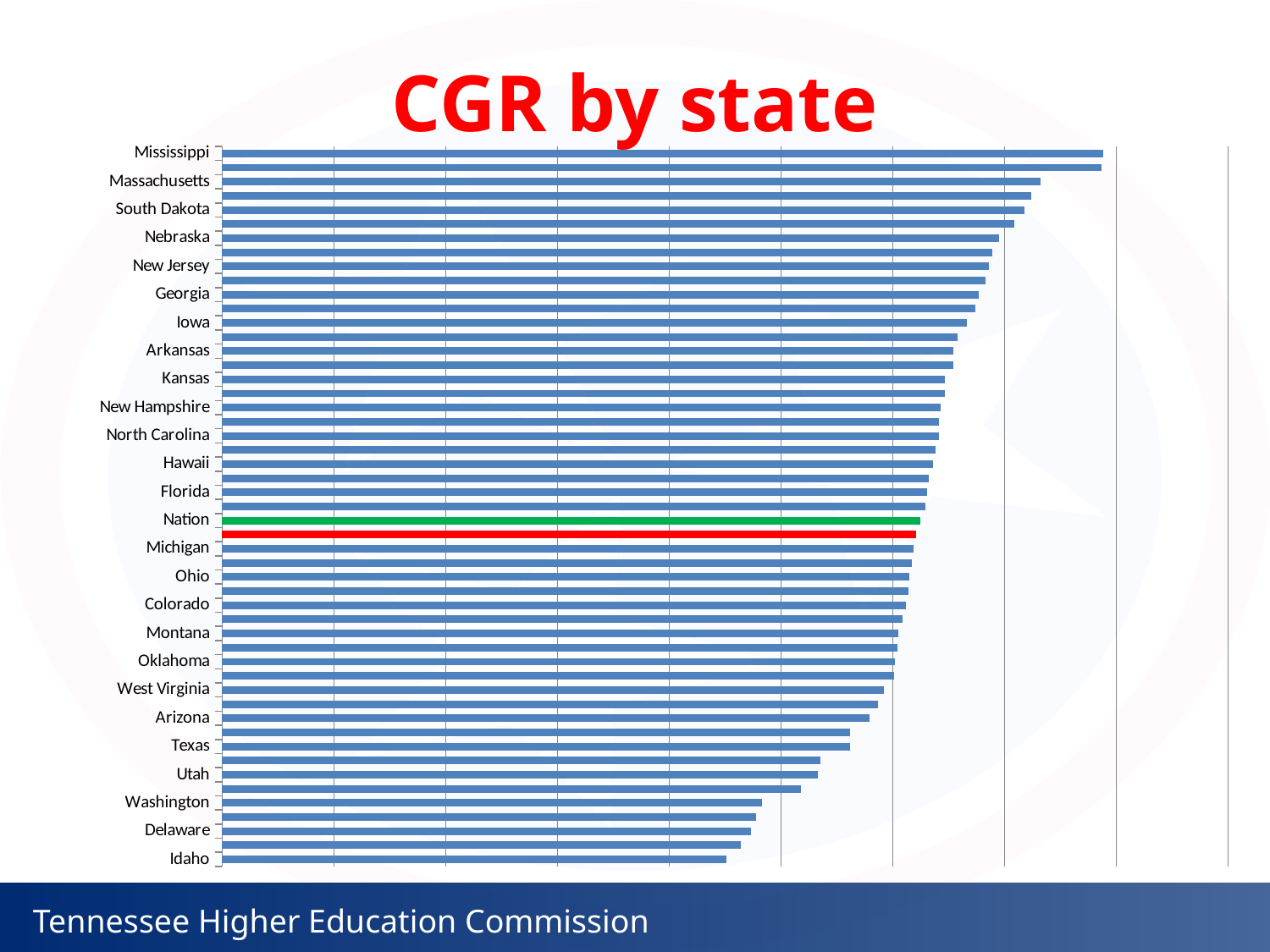
What is the title of the chart? CGR by state Which has the larger value, Washington or Kansas? Kansas Which has the larger value, Mississippi or Idaho? Mississippi Which has the larger value, Georgia or Utah? Georgia Which labeled state has the longest bar in the chart? Mississippi What kind of chart is shown on the slide? bar chart What colour is the bar for Nation? green Which labeled state has the shortest bar in the chart? Idaho Do the bar values rise or fall going from the top of the chart (Mississippi) to the bottom (Idaho)? fall